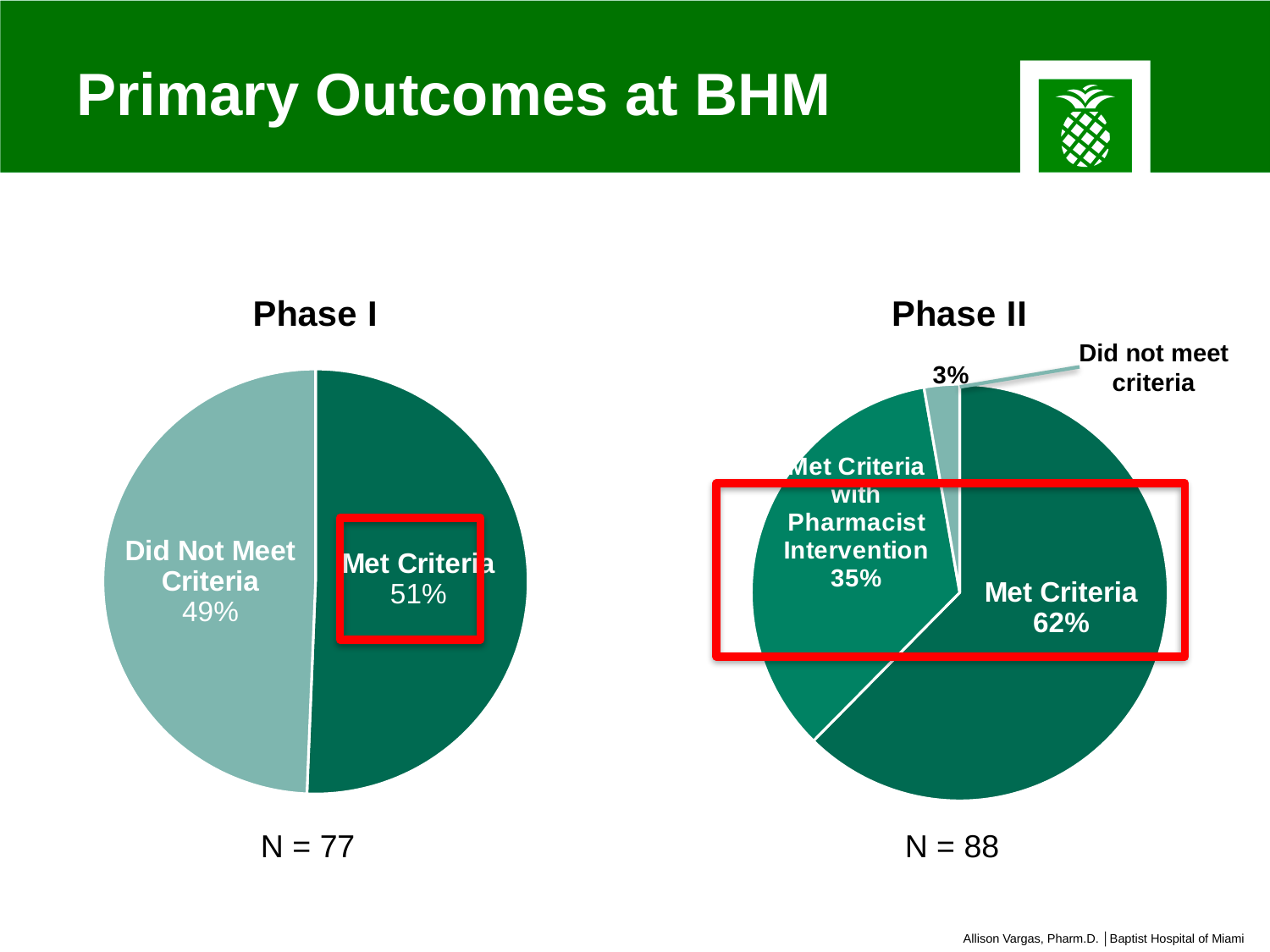
In the Phase I chart, what percentage is shown for Met Criteria? 51% In the Phase II chart, what percentage is shown for Met Criteria? 62% In the Phase II chart, which category has the largest slice? Met Criteria What kind of chart is the Phase I chart? Pie chart In the Phase II chart, what percentage is shown for Did not meet criteria? 3% In the Phase II chart, what percentage is shown for Met Criteria with Pharmacist Intervention? 35% What is the N value shown under the Phase II chart? N = 88 In the Phase II chart, which category has the smallest slice? Did not meet criteria In the Phase II chart, what is the difference between Met Criteria and Met Criteria with Pharmacist Intervention? 27% In the Phase I chart, what is the difference between Met Criteria and Did Not Meet Criteria? 2% How many slices does the Phase II chart have? 3 In the Phase I chart, what percentage is shown for Did Not Meet Criteria? 49%